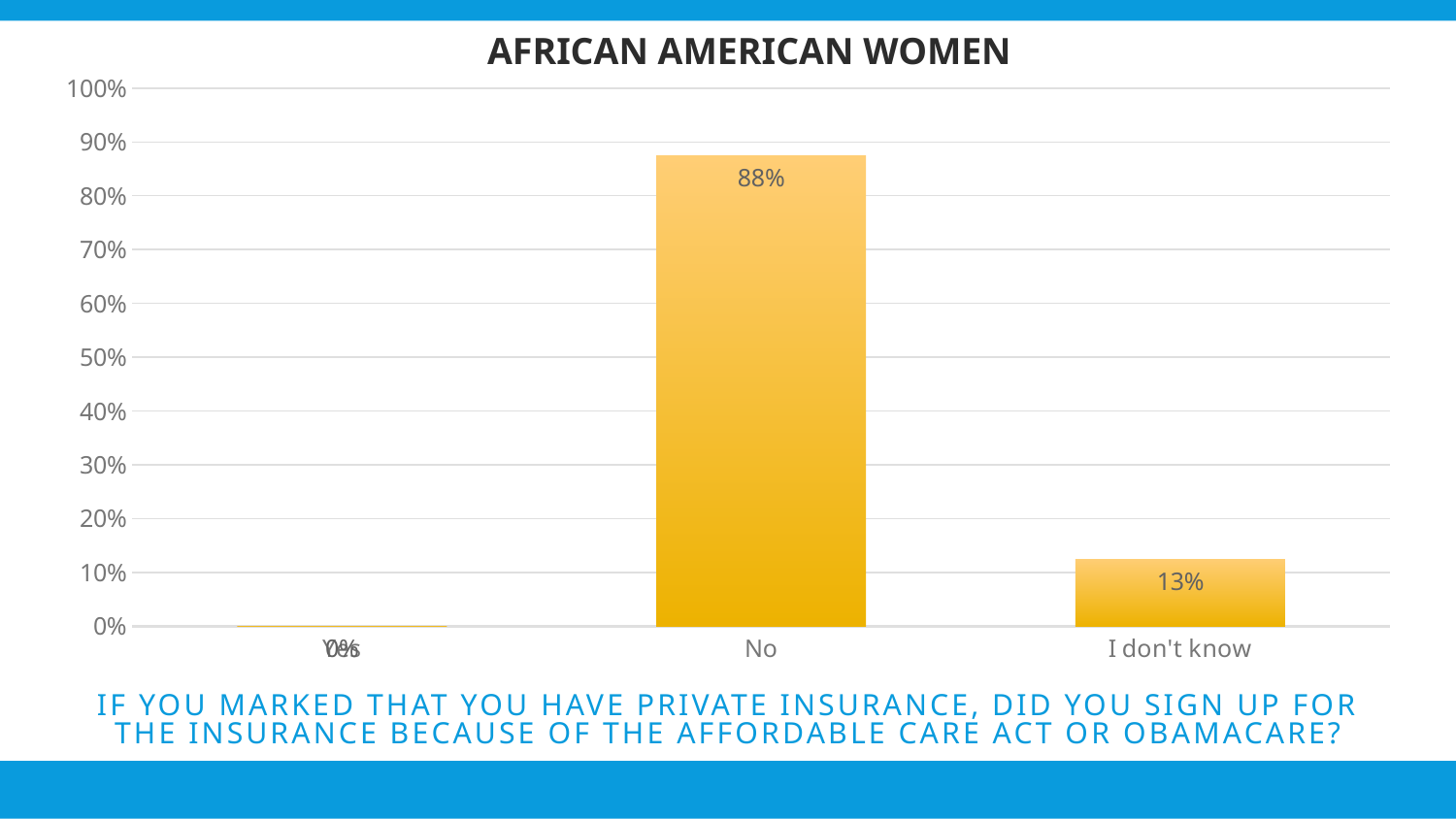
Which category has the highest value? No What kind of chart is shown on the slide? bar chart What is the highest value shown on the y axis? 100% How many categories are shown on the x axis? 3 What is the value for I don't know? 13% What is the difference between the values for No and I don't know? 75% Which category has the lowest value? Yes Which is larger, the value for No or the value for I don't know? No What is the title of the chart? AFRICAN AMERICAN WOMEN Is the value for No greater or less than 80%? greater What is the value for No? 88% Is the value for I don't know greater or less than 20%? less